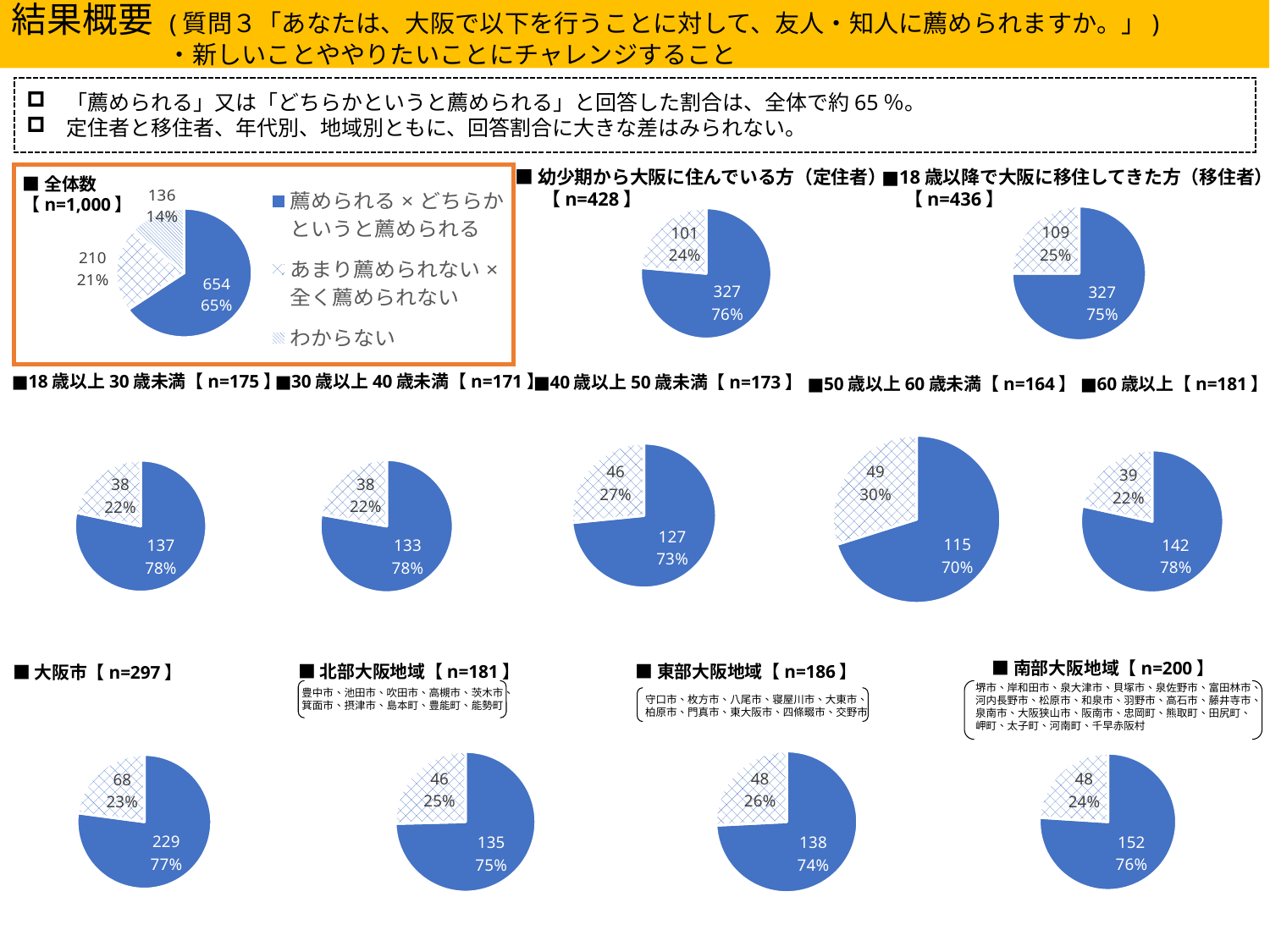
「40歳以上50歳未満【n=173】」と「50歳以上60歳未満【n=164】」の円グラフで、網掛け部分の割合が大きいのはどちらですか。 50歳以上60歳未満【n=164】 「幼少期から大阪に住んでいる方（定住者）【n=428】」の円グラフで、青色の部分の割合は何%ですか。 76% 「全体数【n=1,000】」の円グラフの凡例には、いくつの項目がありますか。 3 「大阪市【n=297】」の円グラフで、網掛け部分の回答数はいくつですか。 68 「60歳以上【n=181】」の円グラフで、青色の部分の回答数はいくつですか。 142 「全体数【n=1,000】」の円グラフで、「わからない」の割合は何%ですか。 14% 「50歳以上60歳未満【n=164】」の円グラフで、青色の部分の割合は何%ですか。 70% 「全体数【n=1,000】」の円グラフで、「薦められる × どちらかというと薦められる」の回答数はいくつですか。 654 「東部大阪地域【n=186】」のグラフはどの種類のグラフですか。 円グラフ 「全体数【n=1,000】」の円グラフで、「あまり薦められない × 全く薦められない」と「わからない」の回答数の差はいくつですか。 74 「18歳以降で大阪に移住してきた方（移住者）【n=436】」の円グラフで、網掛け部分の回答数はいくつですか。 109